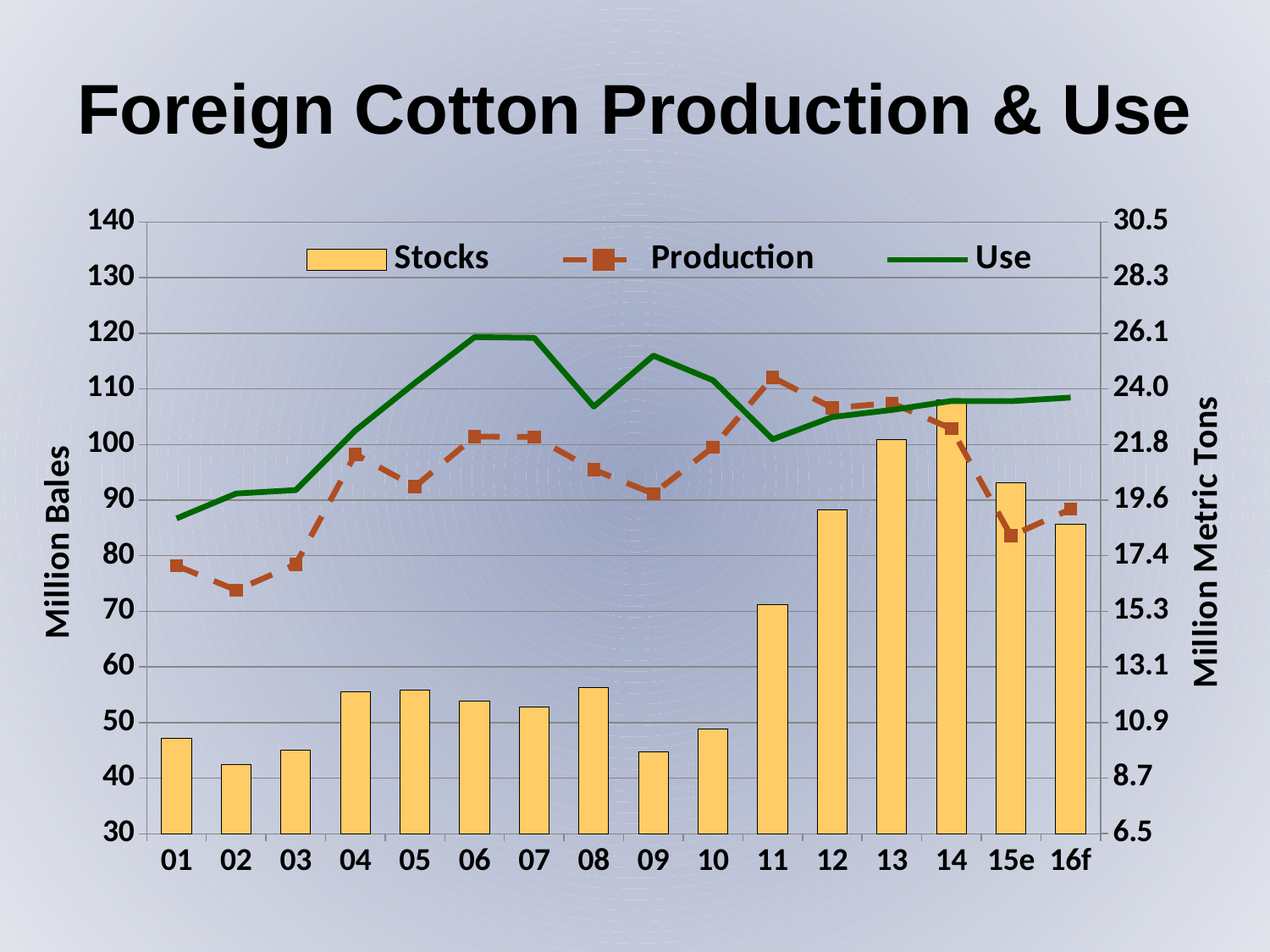
Is the Stocks value for 14 greater or less than 100 million bales? greater Is the Stocks value for 01 greater or less than 50 million bales? less What is the label on the left vertical axis? Million Bales How many years (categories) are shown along the x axis? 16 In which year is the Stocks bar the highest? 14 Which year has the larger Stocks bar, 12 or 13? 13 What kind of chart is shown on the slide? A combination bar and line chart In which year does the Production line reach its lowest point? 02 Is the Stocks value for 12 greater or less than 80 million bales? greater In which year is the Stocks bar the lowest? 02 Does the Use line rise or fall from 01 to 06? Rise How many series does the legend list? 3